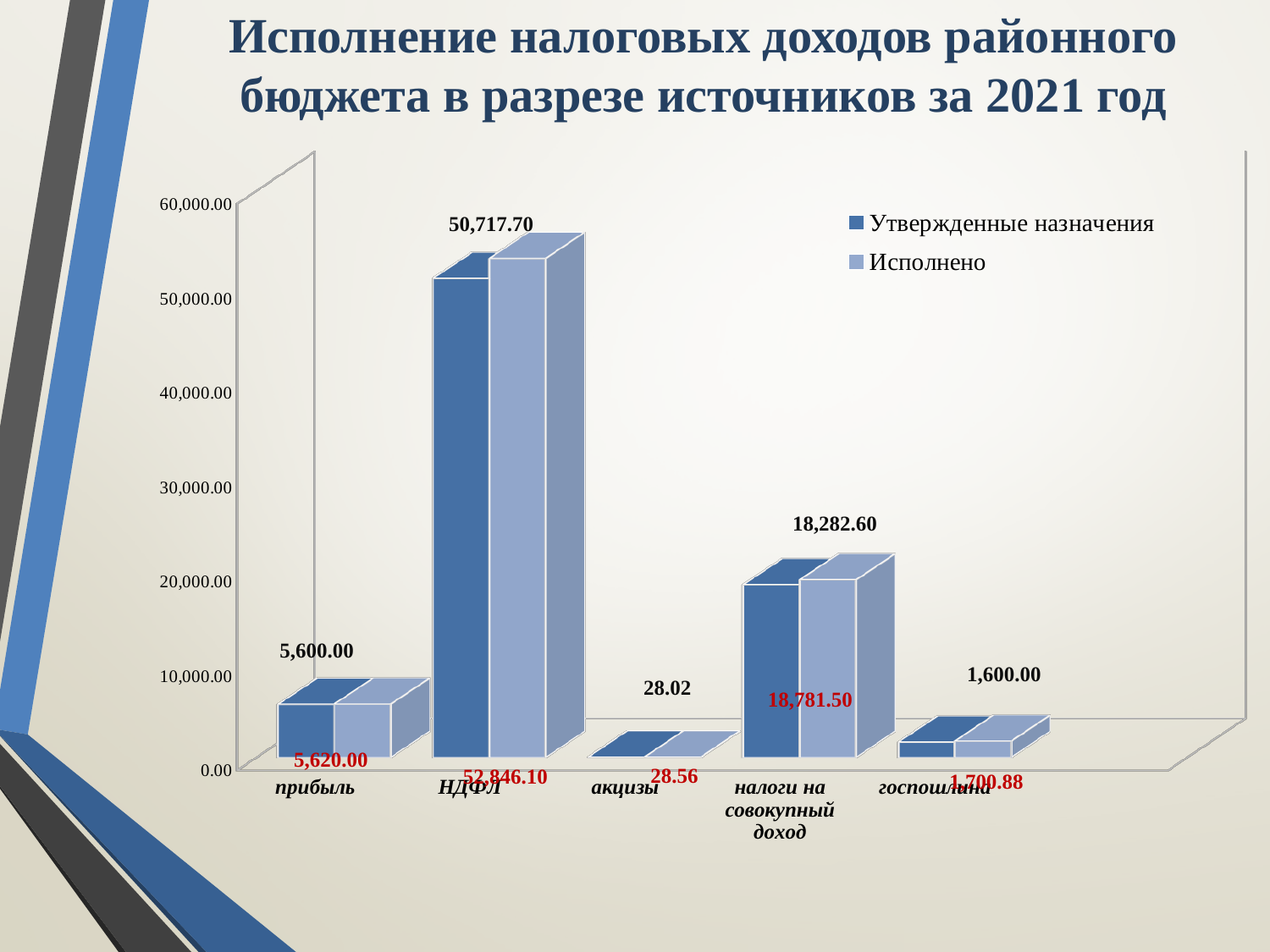
What is the value of Утвержденные назначения for НДФЛ? 50,717.70 Which category has the lowest value for Исполнено? акцизы What is the value of Утвержденные назначения for прибыль? 5,600.00 Which is larger for прибыль: Утвержденные назначения or Исполнено? Исполнено How many categories are shown on the x axis? 5 What is the value of Исполнено for госпошлина? 1,700.88 What type of chart is shown on the slide? bar chart What is the value of Исполнено for налоги на совокупный доход? 18,781.50 What is the value of Исполнено for НДФЛ? 52,846.10 Which category has the highest value for Утвержденные назначения? НДФЛ How many series does the legend list? 2 What is the difference between Исполнено and Утвержденные назначения for налоги на совокупный доход? 498.90